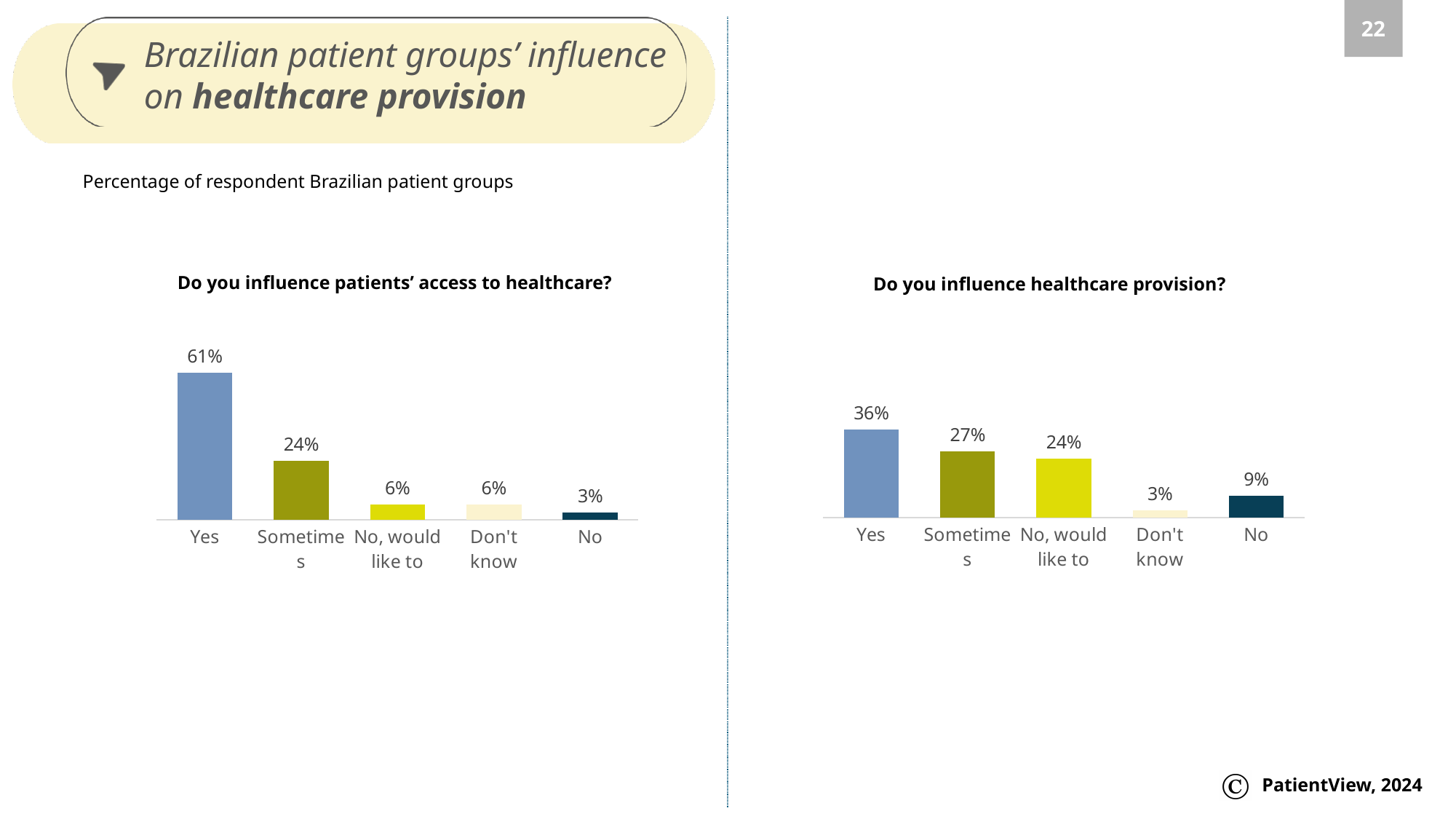
In the chart titled "Do you influence patients' access to healthcare?", what is the value for Yes? 61% In the chart titled "Do you influence healthcare provision?", what is the value for No? 9% In the chart titled "Do you influence healthcare provision?", what is the value for Sometimes? 27% In the chart titled "Do you influence patients' access to healthcare?", which category has the highest value? Yes In the chart titled "Do you influence patients' access to healthcare?", what is the value for Don't know? 6% Which chart has the higher value for Yes, the left chart or the right chart? The left chart What kind of chart is the chart titled "Do you influence healthcare provision?"? Bar chart In the chart titled "Do you influence patients' access to healthcare?", what is the difference between the values for Yes and Sometimes? 37% In the chart titled "Do you influence healthcare provision?", what is the difference between the values for Yes and No, would like to? 12% In the chart titled "Do you influence healthcare provision?", which is larger, the value for Sometimes or the value for No, would like to? Sometimes How many categories are shown in the chart titled "Do you influence patients' access to healthcare?"? 5 In the chart titled "Do you influence healthcare provision?", which category has the lowest value? Don't know